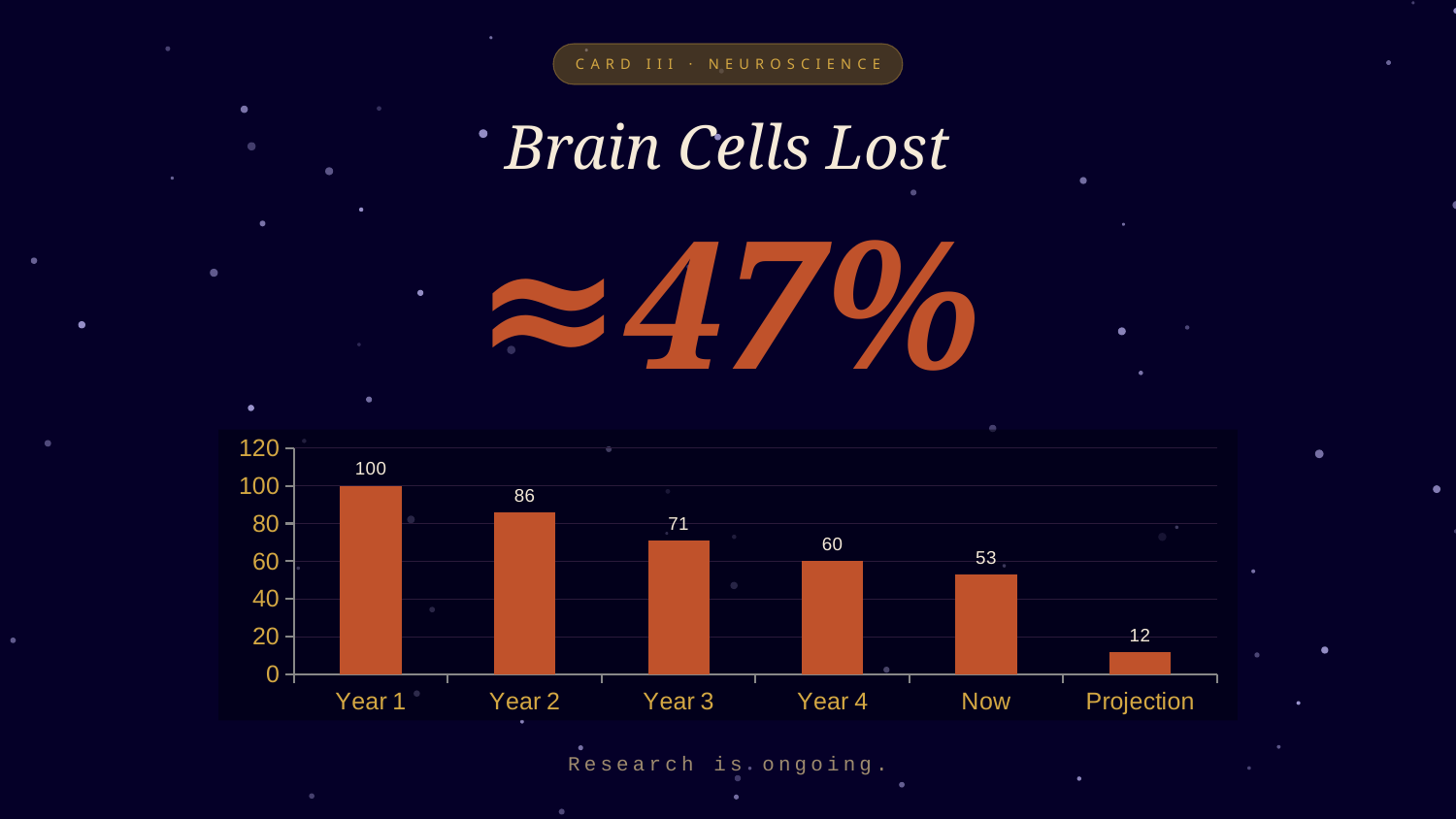
Which is larger, the value for Year 4 or the value for Now? Year 4 How many categories are shown on the x axis? 6 What is the value for Projection? 12 What is the value for Now? 53 What is the difference between the values for Year 1 and Year 2? 14 Do the values rise or fall from Year 1 to Projection? Fall What is the value for Year 3? 71 Which category has the lowest value? Projection What is the difference between the values for Now and Projection? 41 Which category has the highest value? Year 1 What kind of chart is shown on the slide? Bar chart What is the value for Year 1? 100